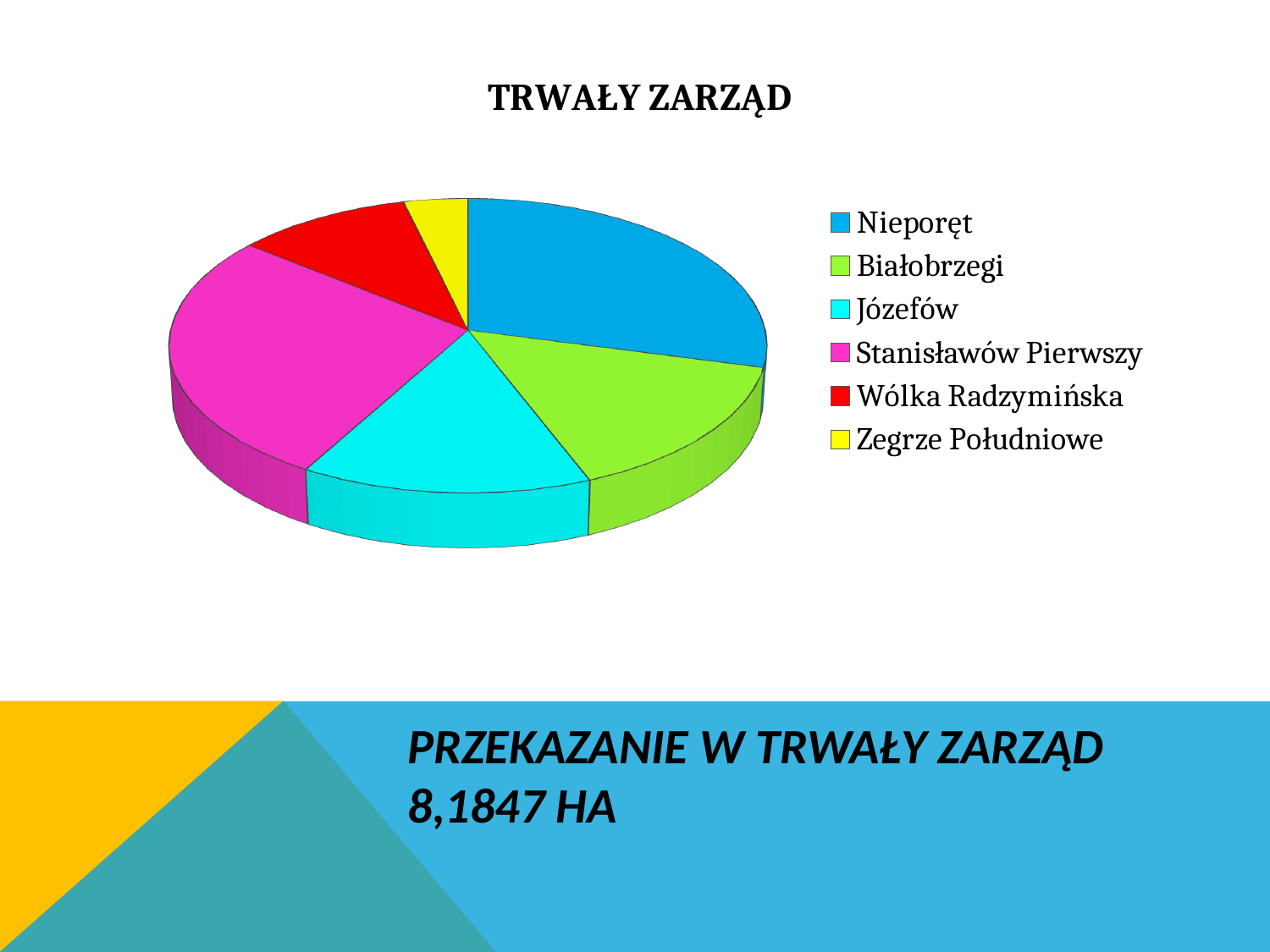
Which slice is larger, Stanisławów Pierwszy or Wólka Radzymińska? Stanisławów Pierwszy Which slice is larger, Józefów or Wólka Radzymińska? Józefów What is the title of the chart? TRWAŁY ZARZĄD What colour is the slice for Józefów? cyan What kind of chart is shown on the slide? pie chart Which slice is larger, Nieporęt or Zegrze Południowe? Nieporęt How many entries does the legend list? 6 How many categories (slices) does the pie chart have? 6 Which category has the smallest slice of the pie? Zegrze Południowe